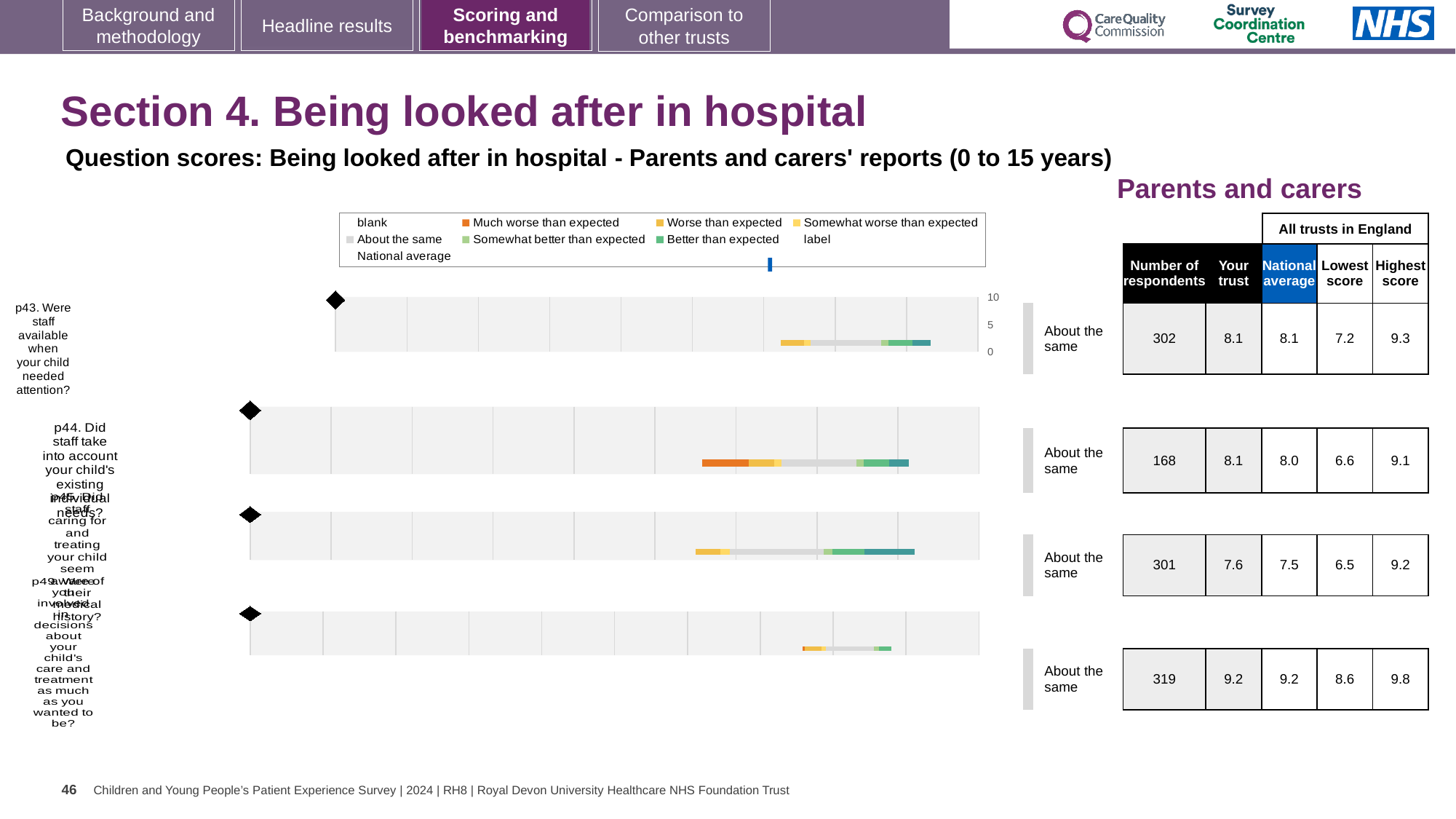
What is the lowest score across all trusts in England for p44? 6.6 For p49 (Were you involved in decisions about your child's care and treatment as much as you wanted to be?), what is the 'Your trust' score? 9.2 What benchmark category is shown next to each of the four question rows? About the same What is the highest score across all trusts in England for p49? 9.8 What kind of chart is used to show the question scores on this slide? bar chart How many questions (chart rows) are plotted on the slide? 4 For p43, what is the difference between the highest score and the lowest score across all trusts in England? 2.1 Which question row has the lowest 'Your trust' score? the third row (p45), 7.6 Which question row has the highest 'Your trust' score? p49 For p43 (Were staff available when your child needed attention?), how many respondents are shown? 302 For the third question row (p45), what is the difference between the 'Your trust' score and the national average? 0.1 For p44, which is larger: the 'Your trust' score or the national average? Your trust (8.1)